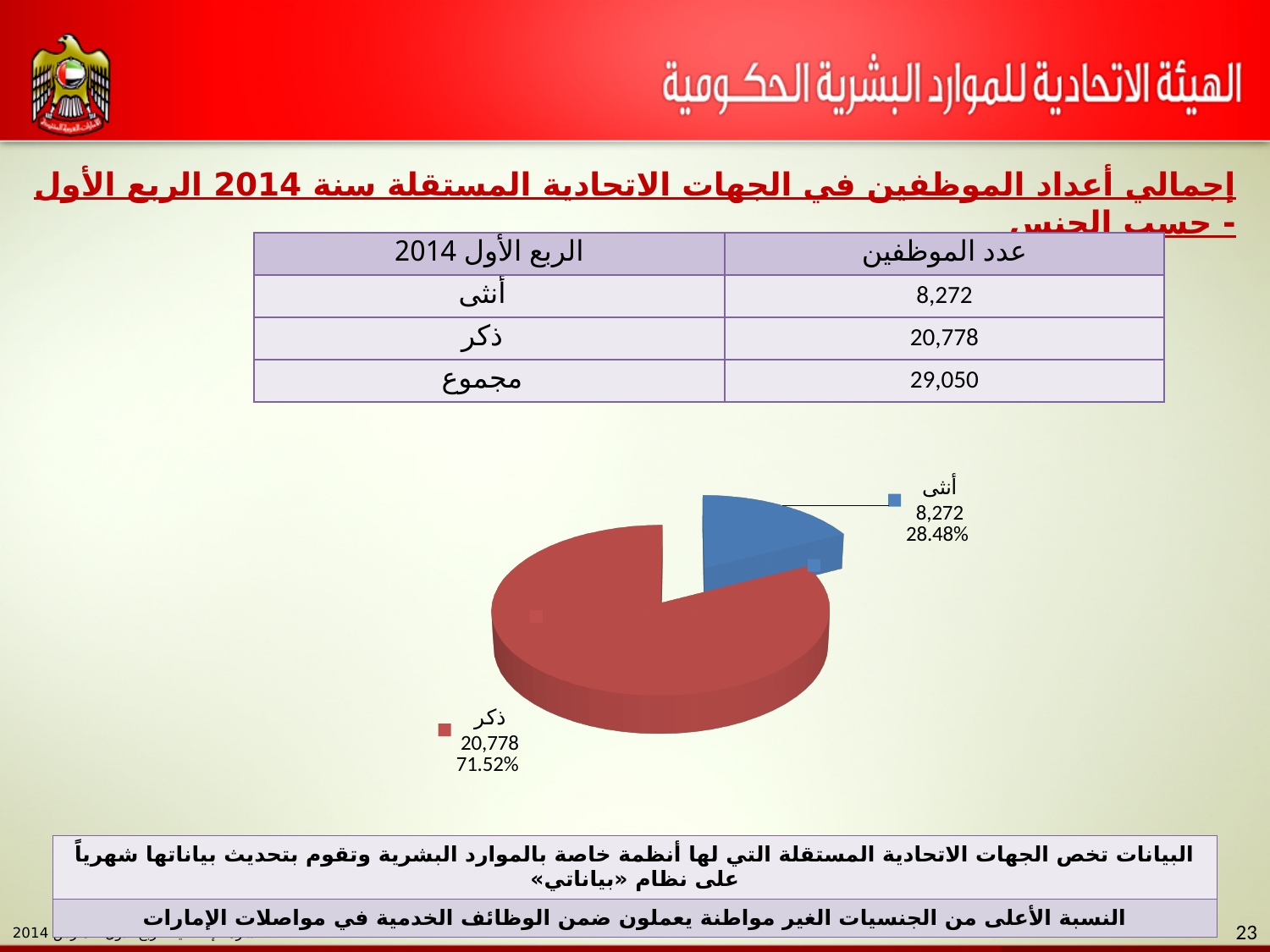
Which slice of the pie chart is the largest? ذكر Which slice of the pie chart is the smallest? أنثى Which is larger in the pie chart, ذكر or أنثى? ذكر How many slices does the pie chart have? 2 What is the difference between the values for ذكر and أنثى in the pie chart? 12,506 What is the total of the two slices in the pie chart? 29,050 What share of the pie does the أنثى slice represent? 28.48% What share of the pie does the ذكر slice represent? 71.52% What colour is the ذكر slice in the pie chart? red What kind of chart is shown on the slide? pie chart What is the value shown for ذكر in the pie chart? 20,778 What is the value shown for أنثى in the pie chart? 8,272